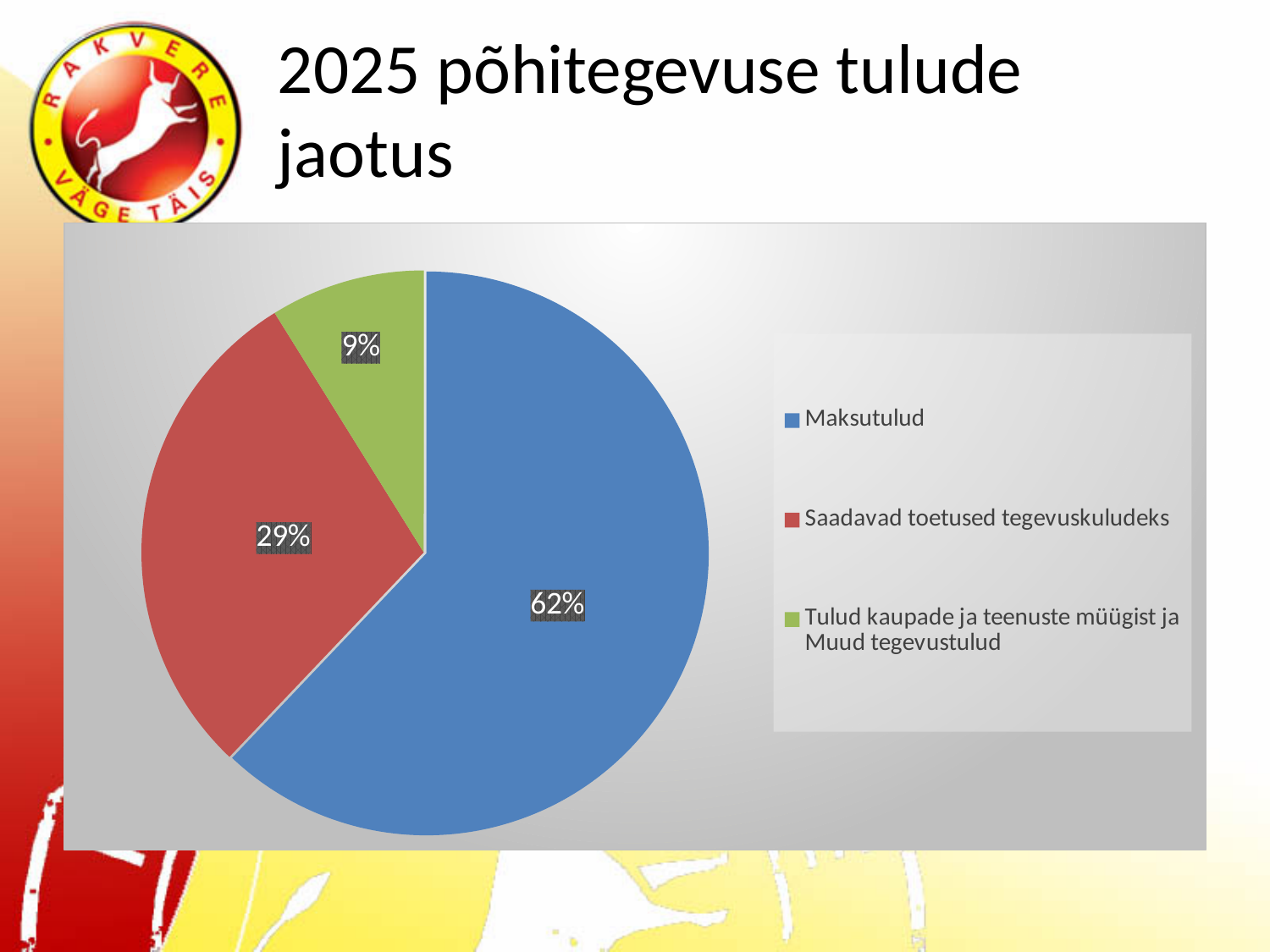
What colour is the slice for Maksutulud? blue What is the title of the slide containing the chart? 2025 põhitegevuse tulude jaotus What share of the pie does Saadavad toetused tegevuskuludeks have? 29% Which category has the largest slice of the pie? Maksutulud What kind of chart is shown on the slide? pie chart Which category has the smallest slice of the pie? Tulud kaupade ja teenuste müügist ja Muud tegevustulud What share of the pie does Maksutulud have? 62% What is the difference in percentage points between Maksutulud and Saadavad toetused tegevuskuludeks? 33 How many entries does the legend list? 3 What share of the pie does Tulud kaupade ja teenuste müügist ja Muud tegevustulud have? 9% How many slices does the pie chart have? 3 Which is larger: Saadavad toetused tegevuskuludeks or Tulud kaupade ja teenuste müügist ja Muud tegevustulud? Saadavad toetused tegevuskuludeks